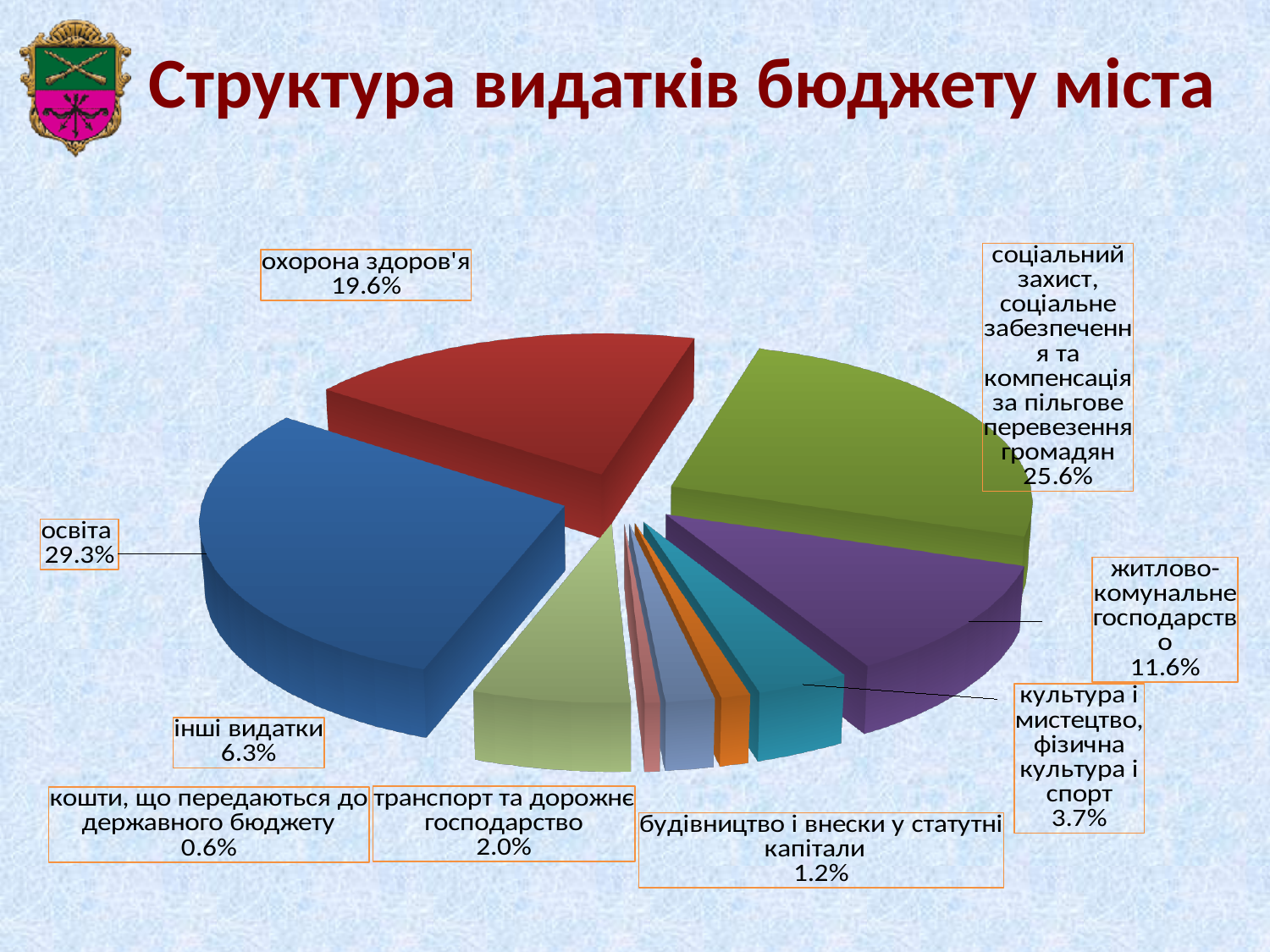
What is the share of охорона здоров'я? 19.6% What percentage is shown for житлово-комунальне господарство? 11.6% Which category has the largest share of the pie? освіта What is the share of транспорт та дорожнє господарство? 2.0% What is the title of the slide? Структура видатків бюджету міста What type of chart is shown on the slide? pie chart How many slices does the pie chart have? 9 Which is larger: інші видатки or культура і мистецтво, фізична культура і спорт? інші видатки Which category has the smallest share of the pie? кошти, що передаються до державного бюджету What is the difference in percentage points between the social protection slice (25.6%) and житлово-комунальне господарство? 14.0 What is the share of освіта in the pie chart? 29.3% What is the difference in percentage points between освіта and охорона здоров'я? 9.7